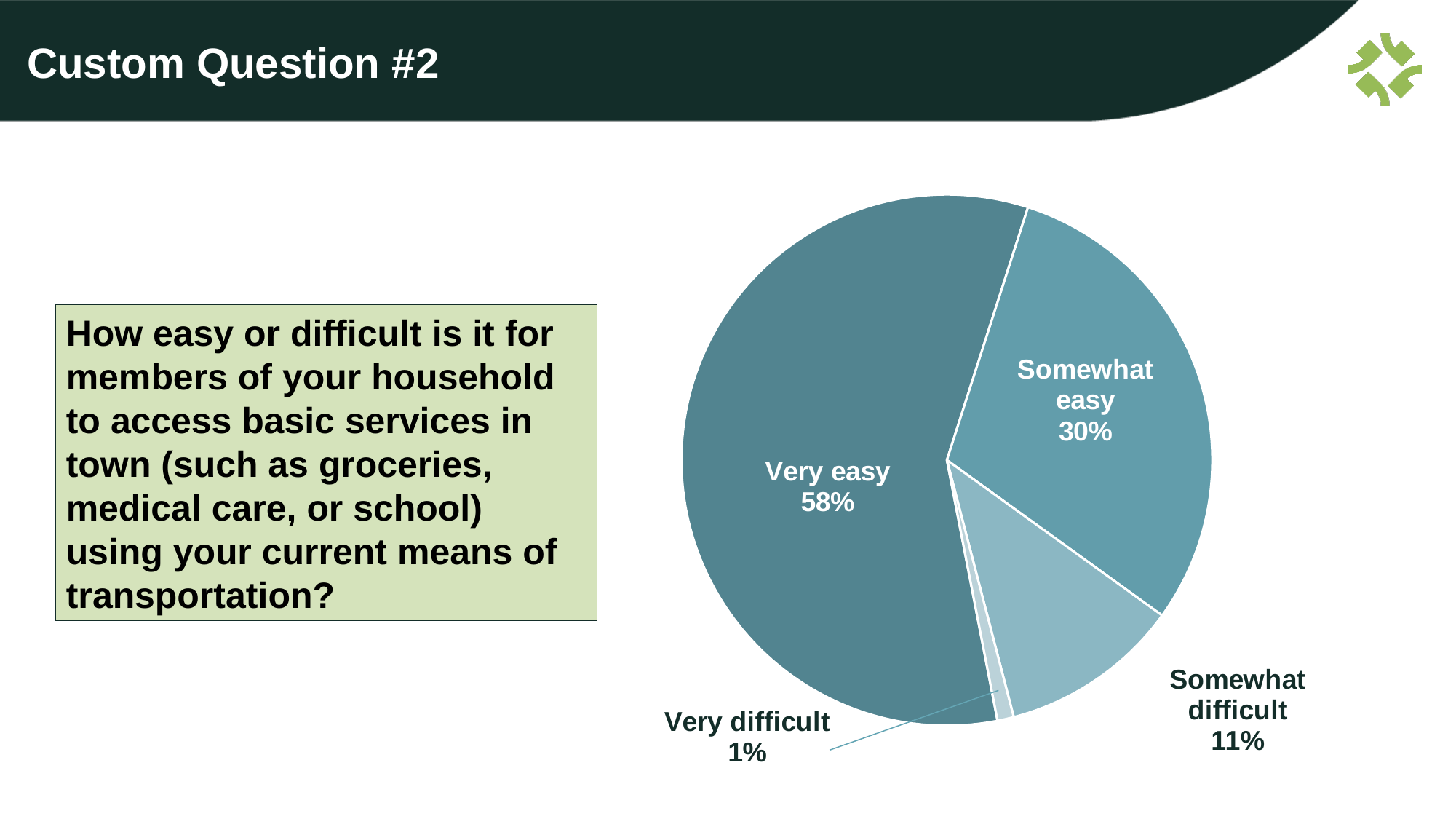
Which is larger, the share for Somewhat easy or the share for Somewhat difficult? Somewhat easy How many slices does the pie chart have? 4 What is the combined share of Somewhat difficult and Very difficult? 12% What is the difference in percentage points between Very easy and Somewhat easy? 28 What kind of chart is shown on the slide? Pie chart Which response category has the largest share of the pie? Very easy What survey question does the pie chart present responses to? How easy or difficult is it for members of your household to access basic services in town (such as groceries, medical care, or school) using your current means of transportation? What percentage of respondents said it is very easy to access basic services? 58% What percentage of respondents said it is very difficult? 1% What percentage of respondents said it is somewhat easy? 30% Which response category has the smallest share of the pie? Very difficult What percentage of respondents said it is somewhat difficult? 11%